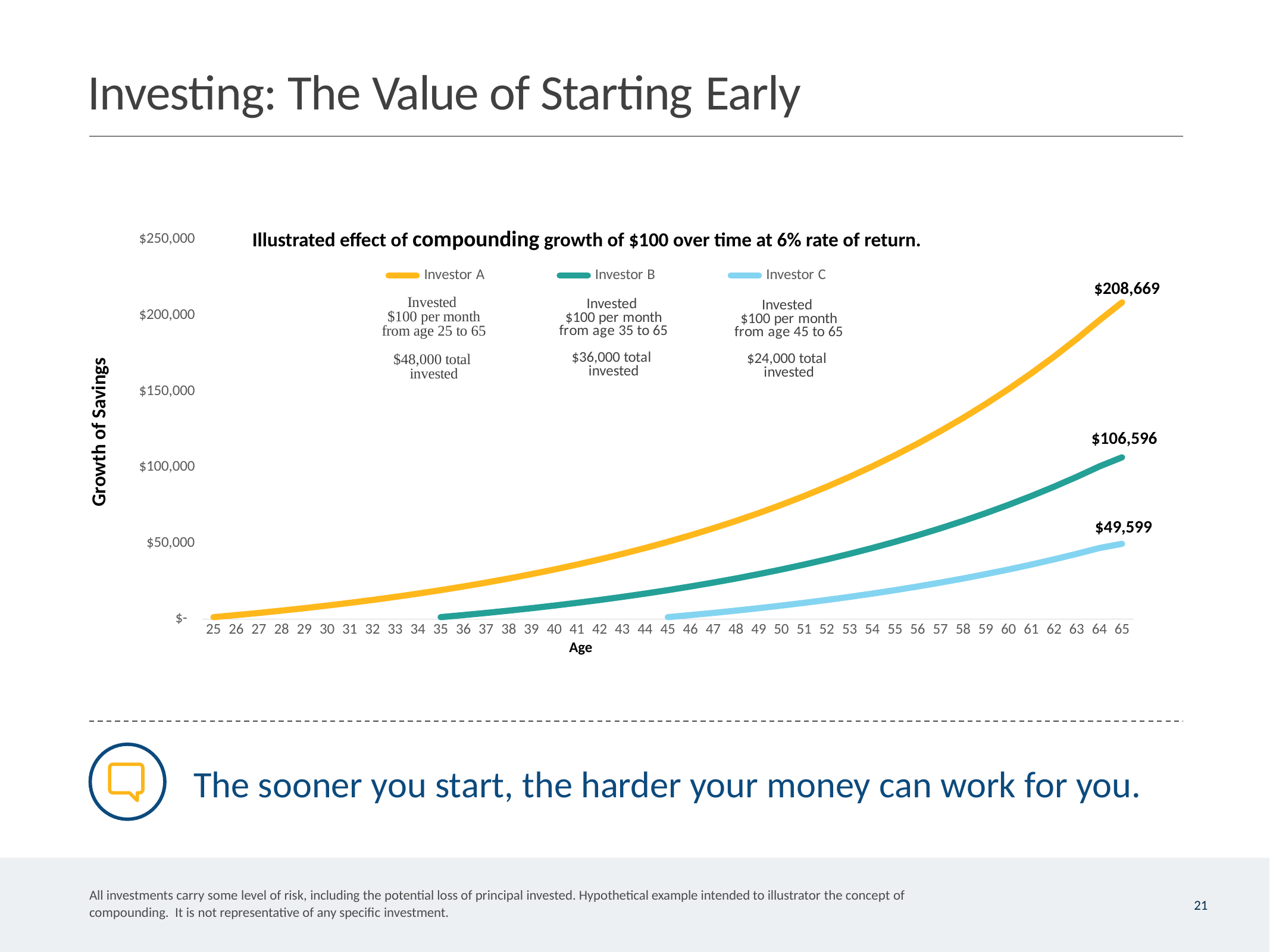
What is the value for Investor C at age 65? $49,599 What is the title of the vertical axis? Growth of Savings Which investor has the lowest savings at age 65? Investor C How many series does the legend list? 3 What kind of chart is shown on the slide? line chart What is the difference between Investor B's and Investor C's savings at age 65? $56,997 Which investor has the highest savings at age 65? Investor A What is the value for Investor B at age 65? $106,596 What is the difference between Investor A's and Investor B's savings at age 65? $102,073 Is the value for Investor A at age 50 greater or less than $100,000? less What is the value for Investor A at age 65? $208,669 Is the value for Investor B at age 60 greater or less than $50,000? greater